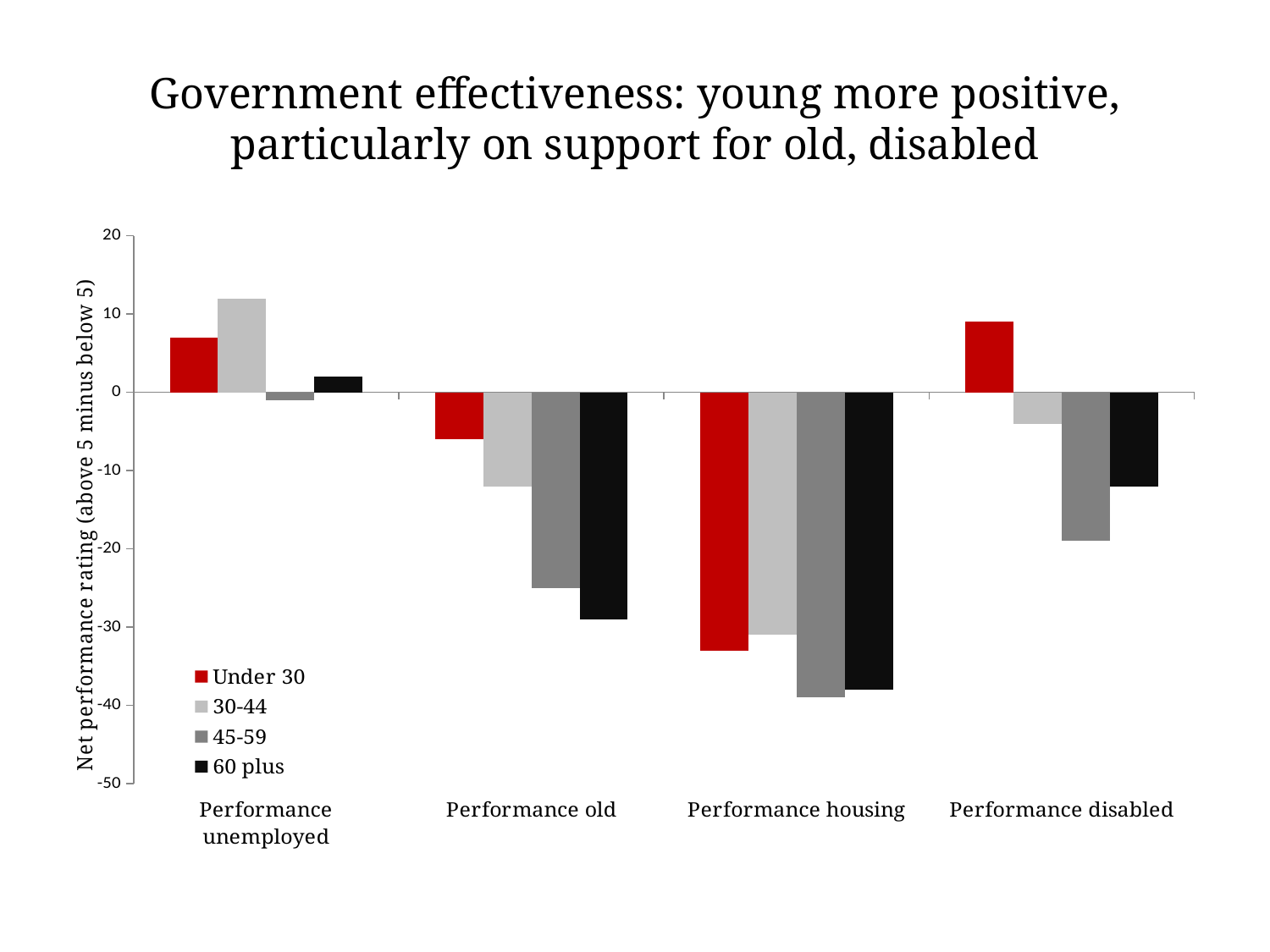
Which category has the lowest value for Under 30? Performance housing What kind of chart is shown on the slide? bar chart What is the label of the vertical axis? Net performance rating (above 5 minus below 5) In Performance disabled, which is larger: the value for 30-44 or the value for 45-59? 30-44 Which age group has the highest value in Performance unemployed? 30-44 Is the value for 60 plus in Performance old greater or less than -20? less Is the value for 30-44 in Performance unemployed greater or less than 10? greater Is the value for Under 30 in Performance disabled greater or less than 0? greater How many series does the legend list? 4 Which age group has the lowest value in Performance old? 60 plus How many categories are shown on the x axis? 4